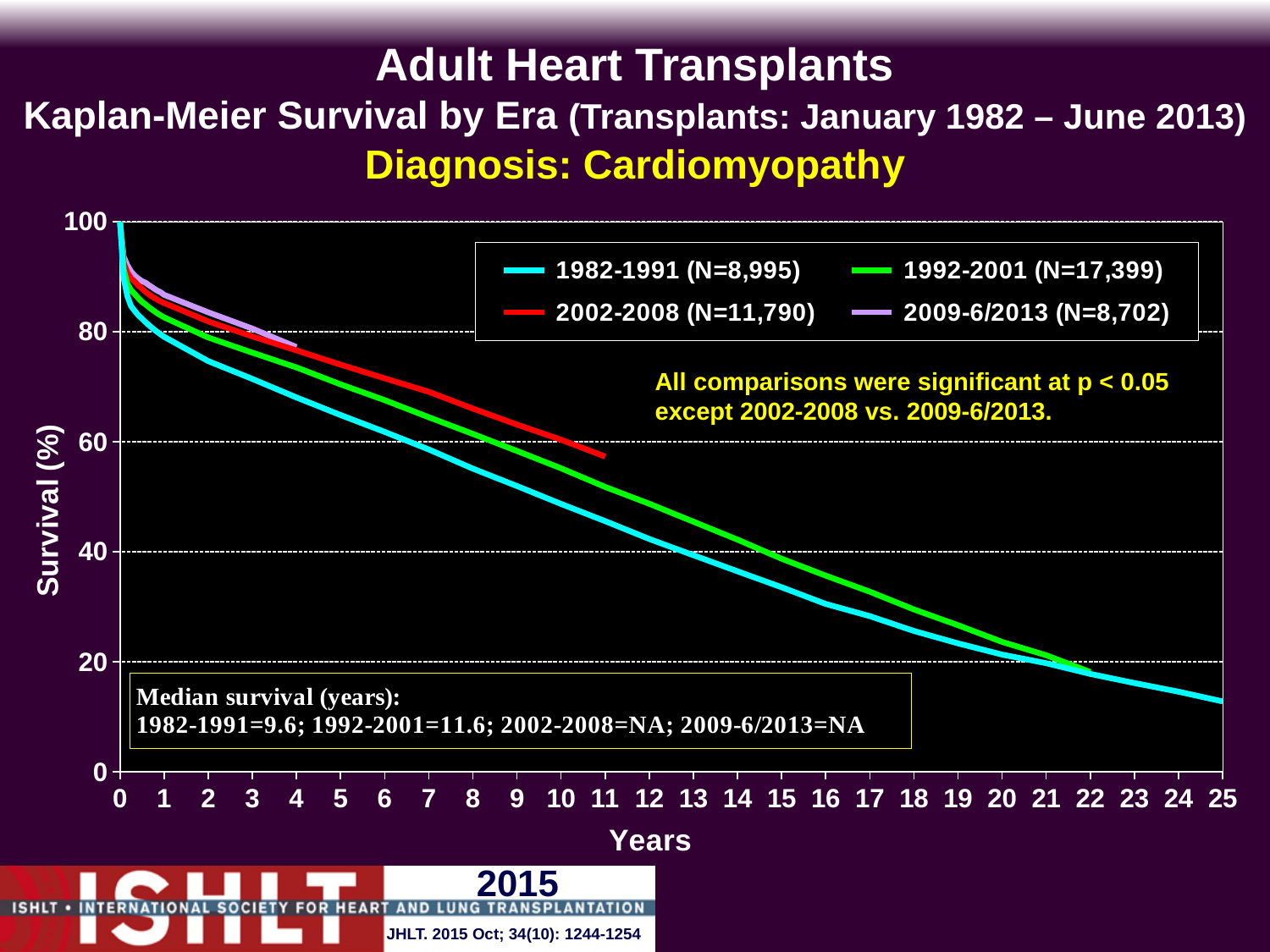
Is the survival value for the 1982-1991 era at 5 years greater or less than 60? greater What is the N for the 1992-2001 era shown in the legend? 17,399 Do the survival curves rise or fall as years increase? fall How many series does the legend list? 4 What colour is the line for the 2002-2008 era? red At 5 years, which era has higher survival, 1982-1991 or 1992-2001? 1992-2001 What is the median survival in years for the 1992-2001 era? 11.6 By how many years does the median survival of the 1992-2001 era exceed that of the 1982-1991 era? 2.0 What kind of chart is shown on the slide? line chart What is the median survival in years for the 1982-1991 era? 9.6 What is the N for the 2009-6/2013 era shown in the legend? 8,702 Is the survival value for the 1982-1991 era at 15 years greater or less than 40? less